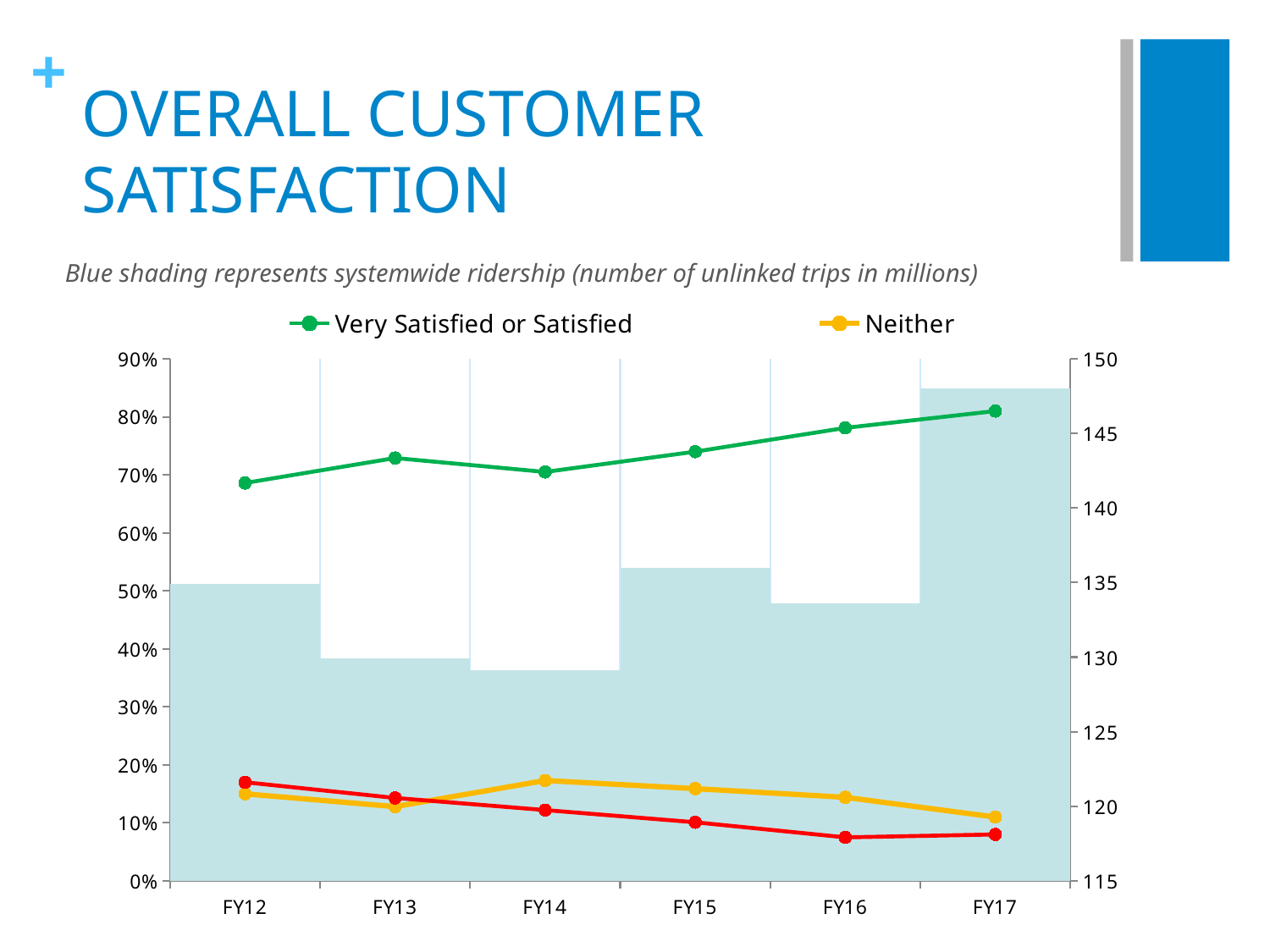
Is the ridership value (blue shading) for FY17 greater or less than 145? greater Does the Very Satisfied or Satisfied line generally rise or fall from FY12 to FY17? rise In which fiscal year is the Very Satisfied or Satisfied value lowest? FY12 Is the Very Satisfied or Satisfied value for FY12 greater or less than 70%? less How many series does the legend list? 2 Is the Very Satisfied or Satisfied value for FY16 greater or less than 70%? greater In which fiscal year is the Very Satisfied or Satisfied value highest? FY17 How many fiscal years are shown on the x axis? 6 According to the slide, what does the blue shading represent? Systemwide ridership (number of unlinked trips in millions) Is the Very Satisfied or Satisfied value larger in FY16 or FY13? FY16 What kind of chart is shown on the slide? combination bar and line chart Which series does the green line represent? Very Satisfied or Satisfied